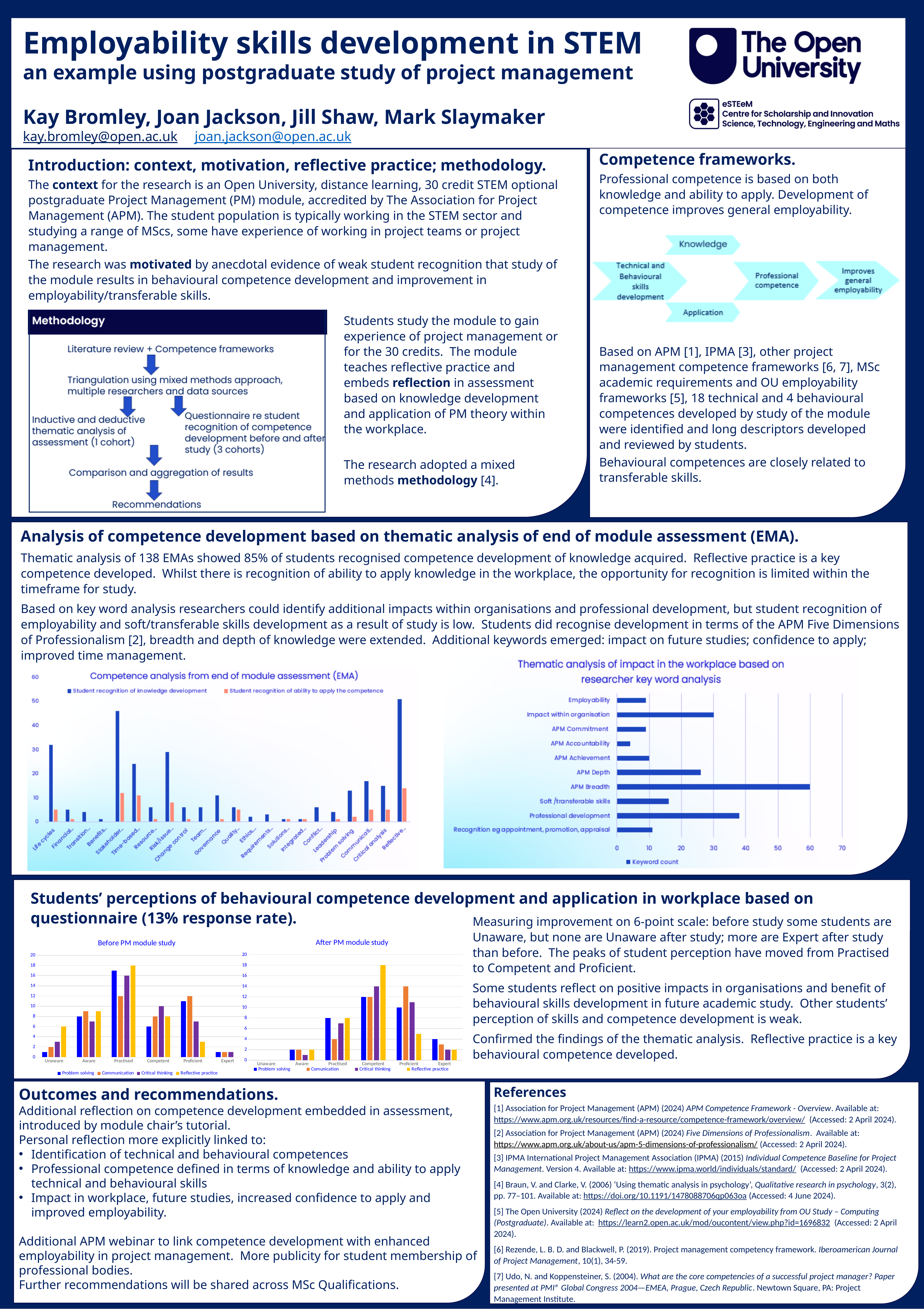
In the 'After PM module study' chart, is the Reflective practice value for Competent greater or less than 15? greater How many series does the legend list in the 'Before PM module study' chart? 4 How many categories are plotted in the 'Thematic analysis of impact in the workplace' chart? 10 In the 'Competence analysis from end of module assessment (EMA)' chart, is the Student recognition of knowledge development value for Stakeholder greater or less than 40? greater In the 'Thematic analysis of impact in the workplace' chart, which category has the highest keyword count? APM Breadth How many categories are shown on the x axis of the 'After PM module study' chart? 6 How many series does the legend list in the 'Competence analysis from end of module assessment (EMA)' chart? 2 In the 'Thematic analysis of impact in the workplace' chart, which category has the lowest keyword count? APM Accountability In the 'Thematic analysis of impact in the workplace' chart, is the keyword count for APM Breadth greater or less than 50? greater In the 'Competence analysis from end of module assessment (EMA)' chart, which category has the highest value for Student recognition of knowledge development? Reflective What kind of chart is the 'Thematic analysis of impact in the workplace based on researcher key word analysis' chart? bar chart In the 'Thematic analysis of impact in the workplace' chart, which has the larger keyword count: Professional development or Impact within organisation? Professional development